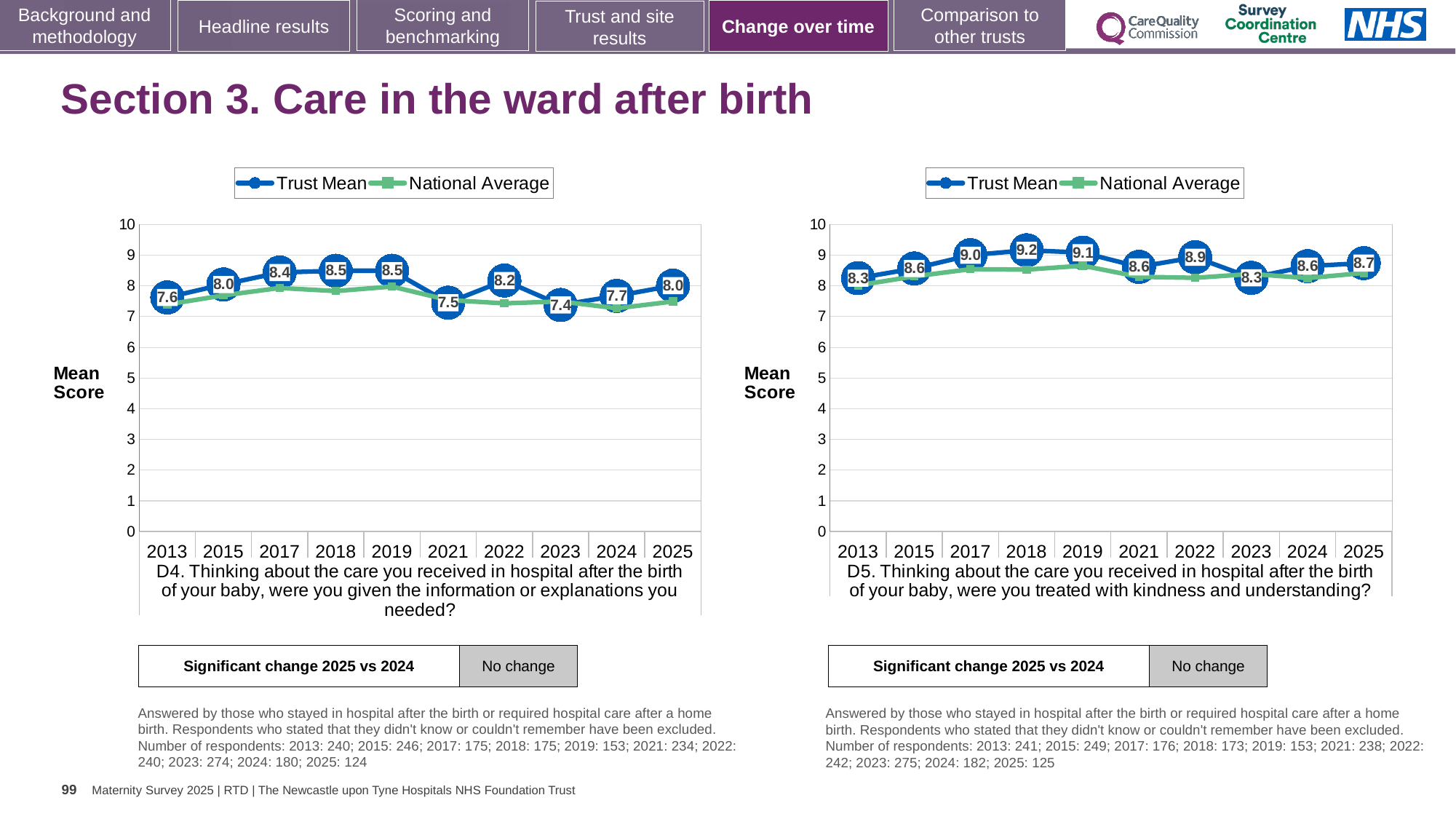
On the D4 chart (left), is the National Average for 2013 greater or less than 8? less On the D5 chart (right), in which year is the Trust Mean highest? 2018 On the D5 chart (right), what is the Trust Mean for 2023? 8.3 On the D5 chart (right), which year has the larger Trust Mean, 2022 or 2024? 2022 On the D4 chart (left), what is the Trust Mean for 2025? 8.0 On the D5 chart (right), is the National Average for 2019 greater or less than 8? greater How many series does the legend of the D5 chart (right) list? 2 On the D4 chart (left), in which year is the Trust Mean lowest? 2023 On the D5 chart (right), what is the Trust Mean for 2018? 9.2 How many years are shown on the x axis of the D4 chart (left)? 10 On the D4 chart (left), what is the Trust Mean for 2013? 7.6 On the D4 chart (left), what is the difference between the Trust Mean in 2019 and in 2021? 1.0